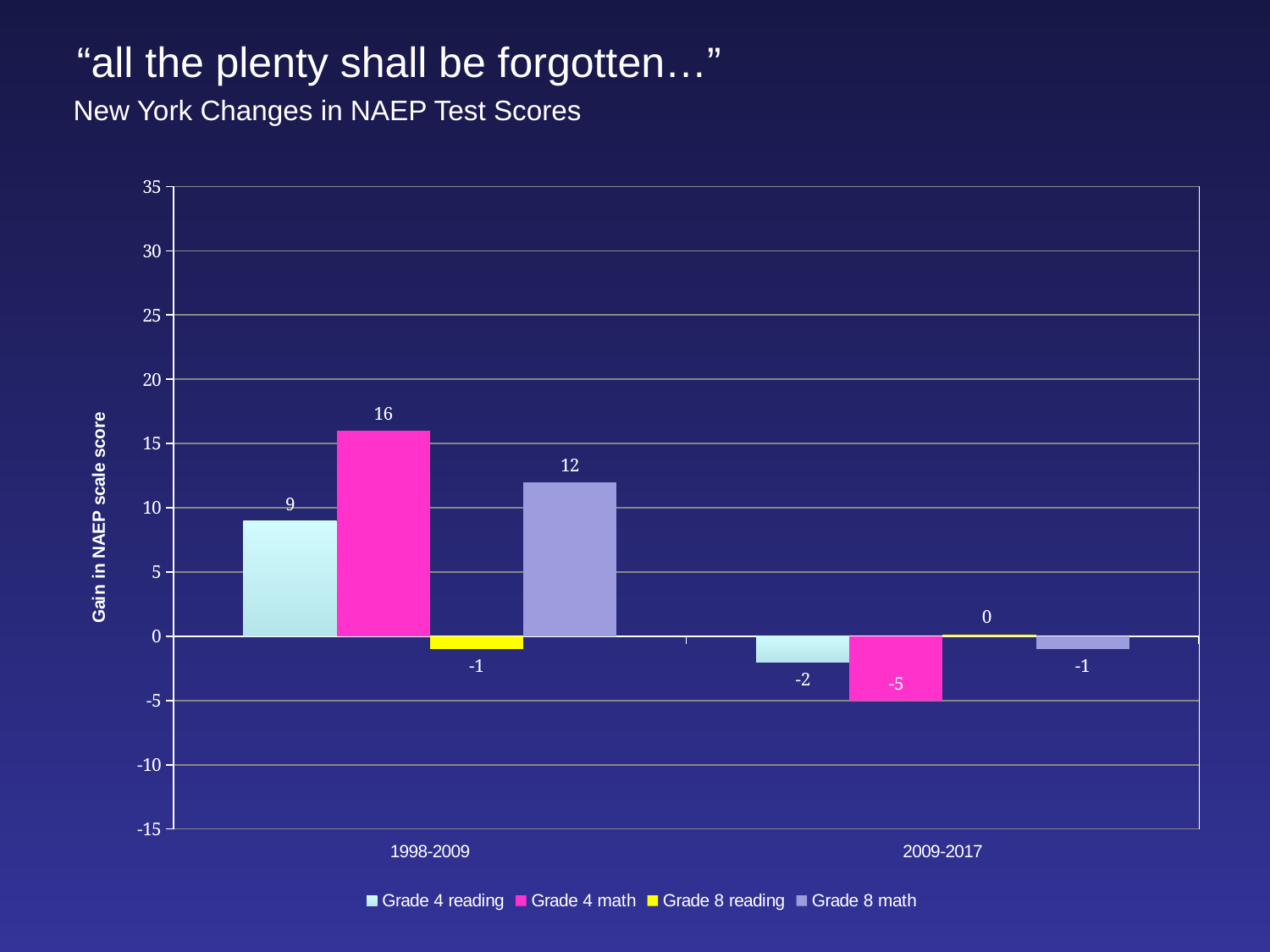
Which series has the lowest value in the 2009-2017 period? Grade 4 math What is the gain in NAEP scale score for Grade 4 math in 1998-2009? 16 Which is larger: Grade 4 reading in 1998-2009 or Grade 8 math in 1998-2009? Grade 8 math in 1998-2009 What is the label of the vertical axis? Gain in NAEP scale score Which series has the highest value in the 1998-2009 period? Grade 4 math How many time periods are shown on the x axis? 2 What is the difference between the Grade 4 math values for 1998-2009 and 2009-2017? 21 What is the value for Grade 4 math in 2009-2017? -5 What is the value for Grade 8 math in 1998-2009? 12 What is the value for Grade 8 reading in 2009-2017? 0 How many series does the legend list? 4 What kind of chart is shown on the slide? Bar chart